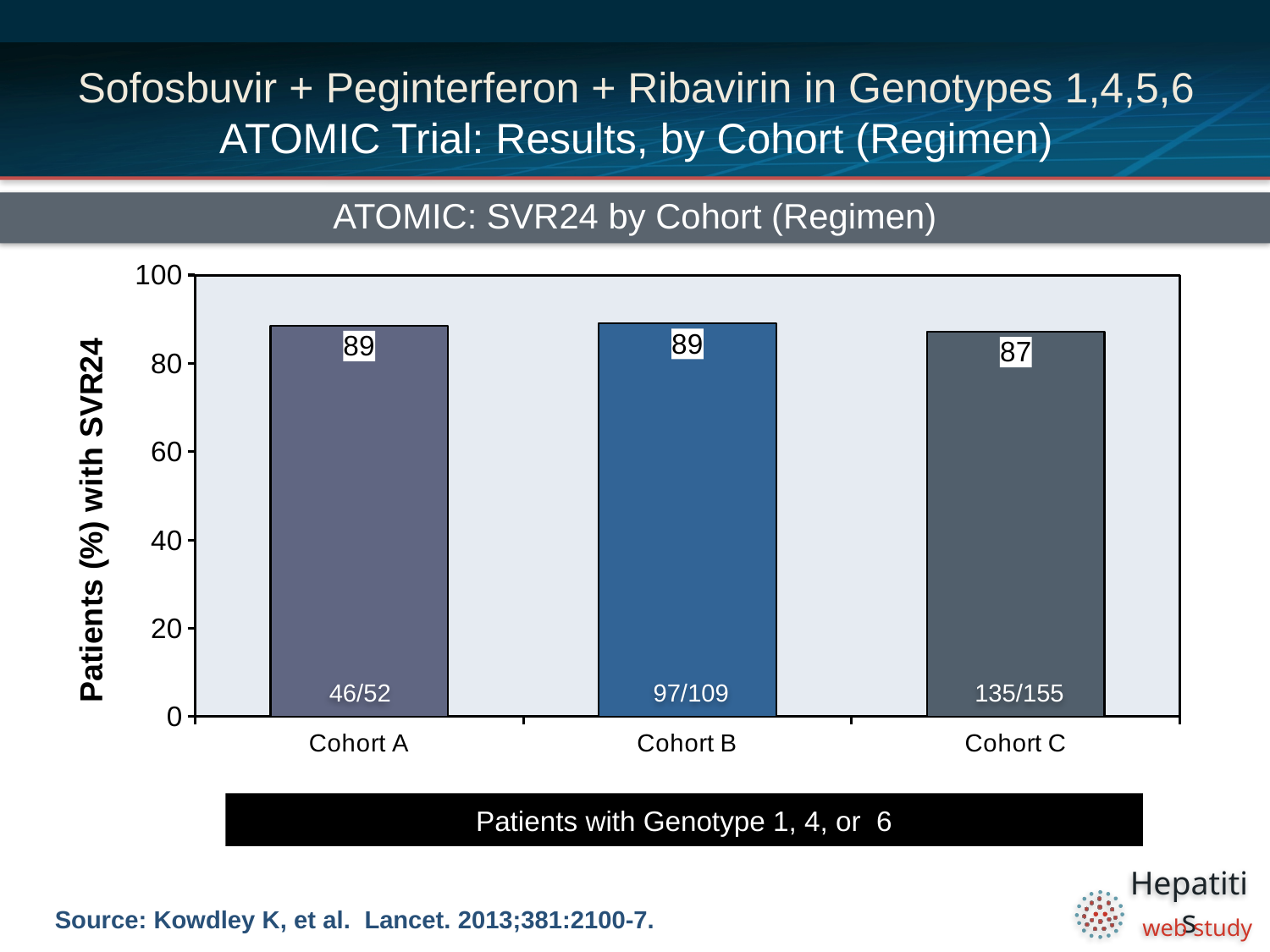
What kind of chart is shown on the slide? Bar chart Is the value for Cohort C greater or less than 80? greater What is the value for Cohort B? 89 Which cohort has the lowest SVR24 value? Cohort C What fraction of patients is shown at the base of the Cohort B bar? 97/109 Which is larger, the value for Cohort B or the value for Cohort C? Cohort B What fraction of patients is shown at the base of the Cohort C bar? 135/155 What is the value for Cohort C? 87 What is the value for Cohort A? 89 What fraction of patients is shown at the base of the Cohort A bar? 46/52 How many cohorts are shown on the chart? 3 What is the difference between the values for Cohort A and Cohort C? 2